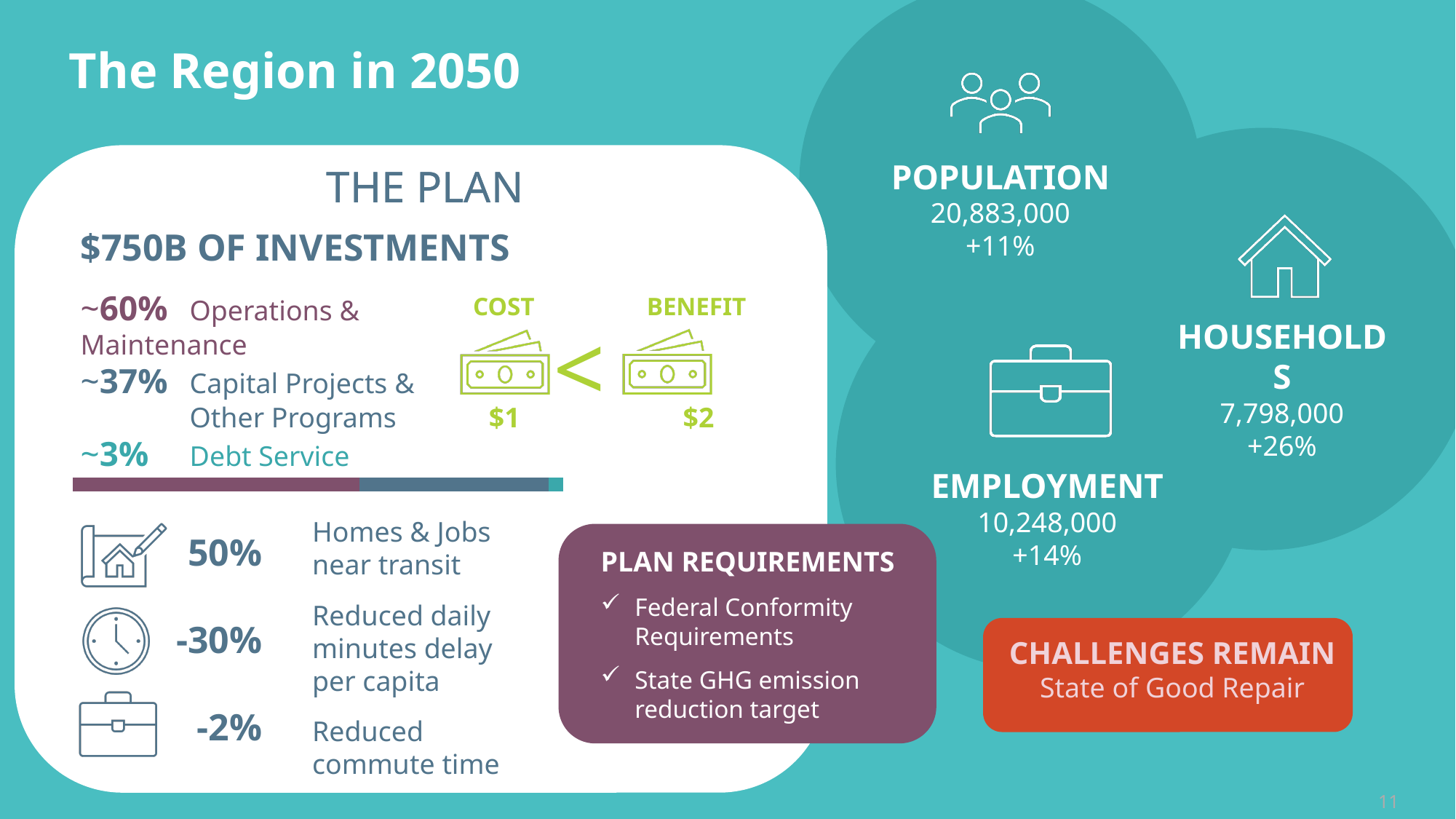
Which category takes the largest share of the $750B of investments? Operations & Maintenance What total amount of investments does the breakdown bar represent? $750B In the investment breakdown bar, what share is allocated to Capital Projects & Other Programs? ~37% What colour is the Debt Service segment of the investment breakdown bar? Teal What kind of chart is used to show the investment breakdown under THE PLAN? Stacked bar chart In the investment breakdown bar, what share is allocated to Debt Service? ~3% How many categories are shown in the investment breakdown bar? 3 Which category takes the smallest share of the $750B of investments? Debt Service In the investment breakdown bar, what share is allocated to Operations & Maintenance? ~60% Which is larger: the share for Operations & Maintenance or the share for Capital Projects & Other Programs? Operations & Maintenance